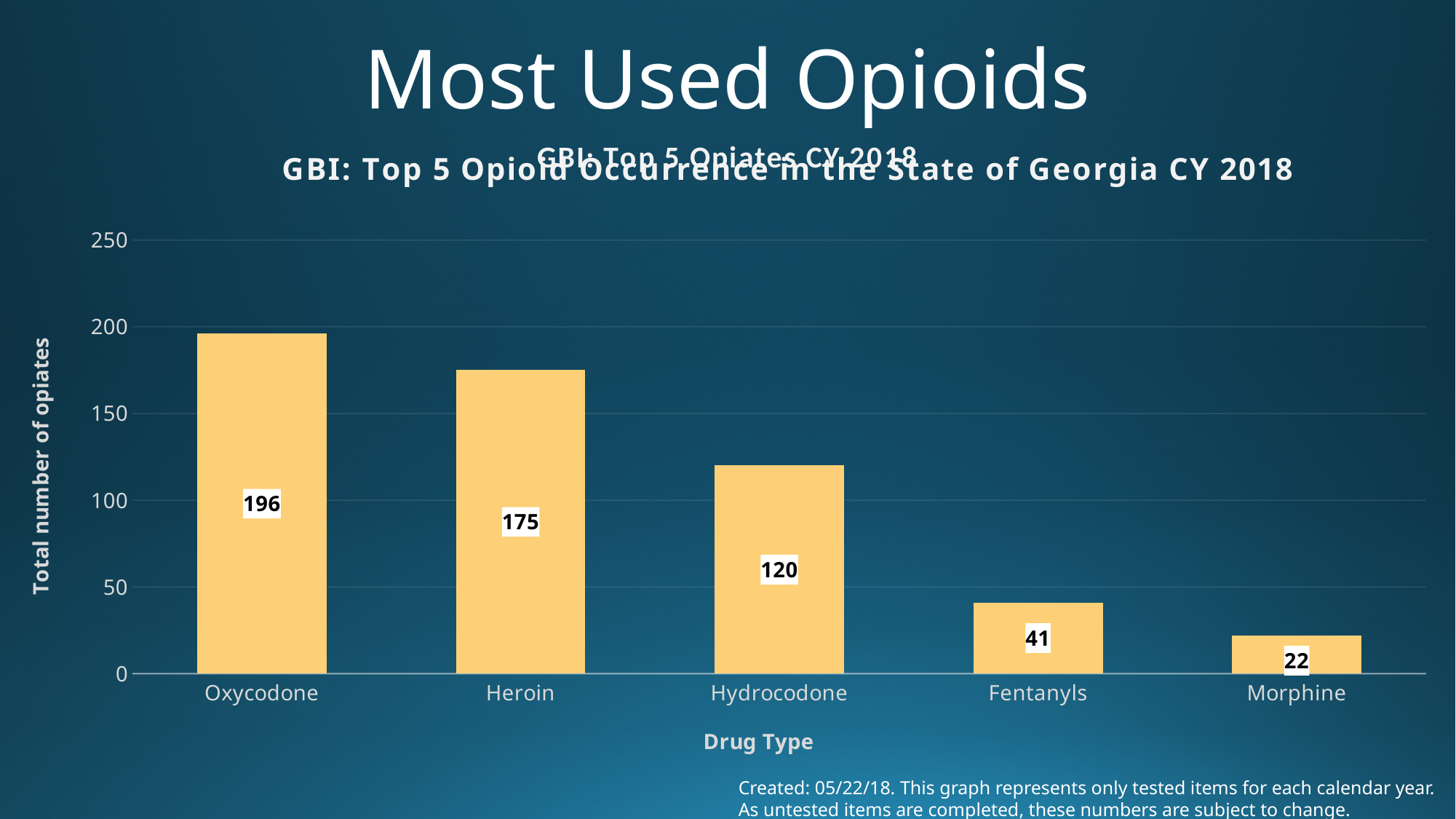
What is the value for Hydrocodone? 120 How many drug types are shown on the x axis? 5 What is the label of the y axis? Total number of opiates What kind of chart is shown on the slide? Bar chart Which is larger, the value for Hydrocodone or the value for Fentanyls? Hydrocodone Which drug type has the highest value? Oxycodone What is the difference between the values for Oxycodone and Heroin? 21 What is the value for Oxycodone? 196 Which drug type has the lowest value? Morphine What is the value for Heroin? 175 What is the value for Fentanyls? 41 What is the value for Morphine? 22